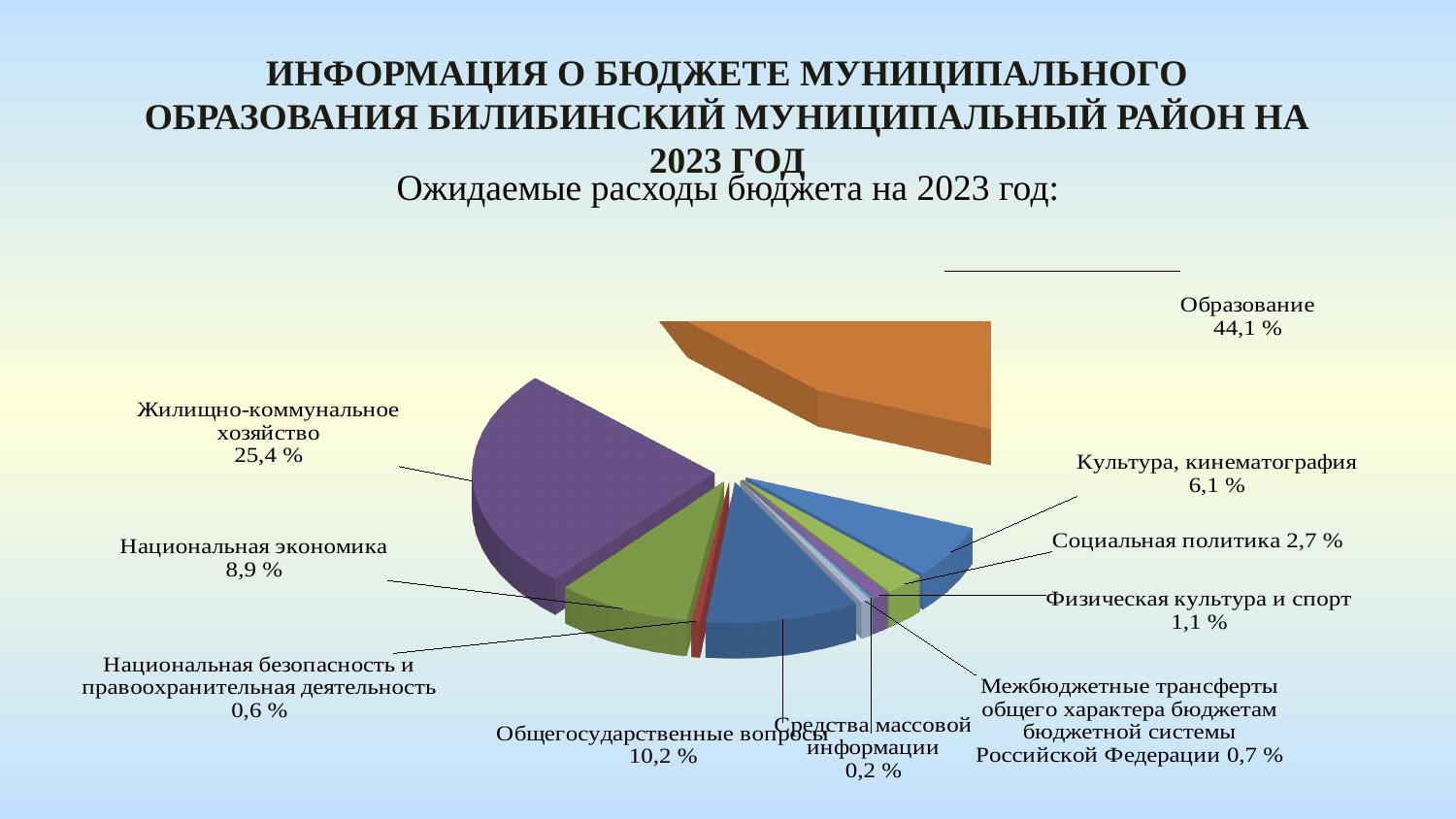
Which category has the largest share of expected 2023 budget expenditures? Образование How many categories are shown in the pie chart? 10 What share is shown for Общегосударственные вопросы? 10,2 % What share of expected 2023 budget expenditures goes to Жилищно-коммунальное хозяйство? 25,4 % What kind of chart is shown on the slide? pie chart Which has a larger share: Национальная экономика or Общегосударственные вопросы? Общегосударственные вопросы What share is shown for Средства массовой информации? 0,2 % What share is shown for Культура, кинематография? 6,1 % What is the difference in percentage points between Образование and Жилищно-коммунальное хозяйство? 18,7 What share of expected 2023 budget expenditures goes to Образование? 44,1 % Which category has the smallest share of expected 2023 budget expenditures? Средства массовой информации What is the subtitle above the pie chart? Ожидаемые расходы бюджета на 2023 год: